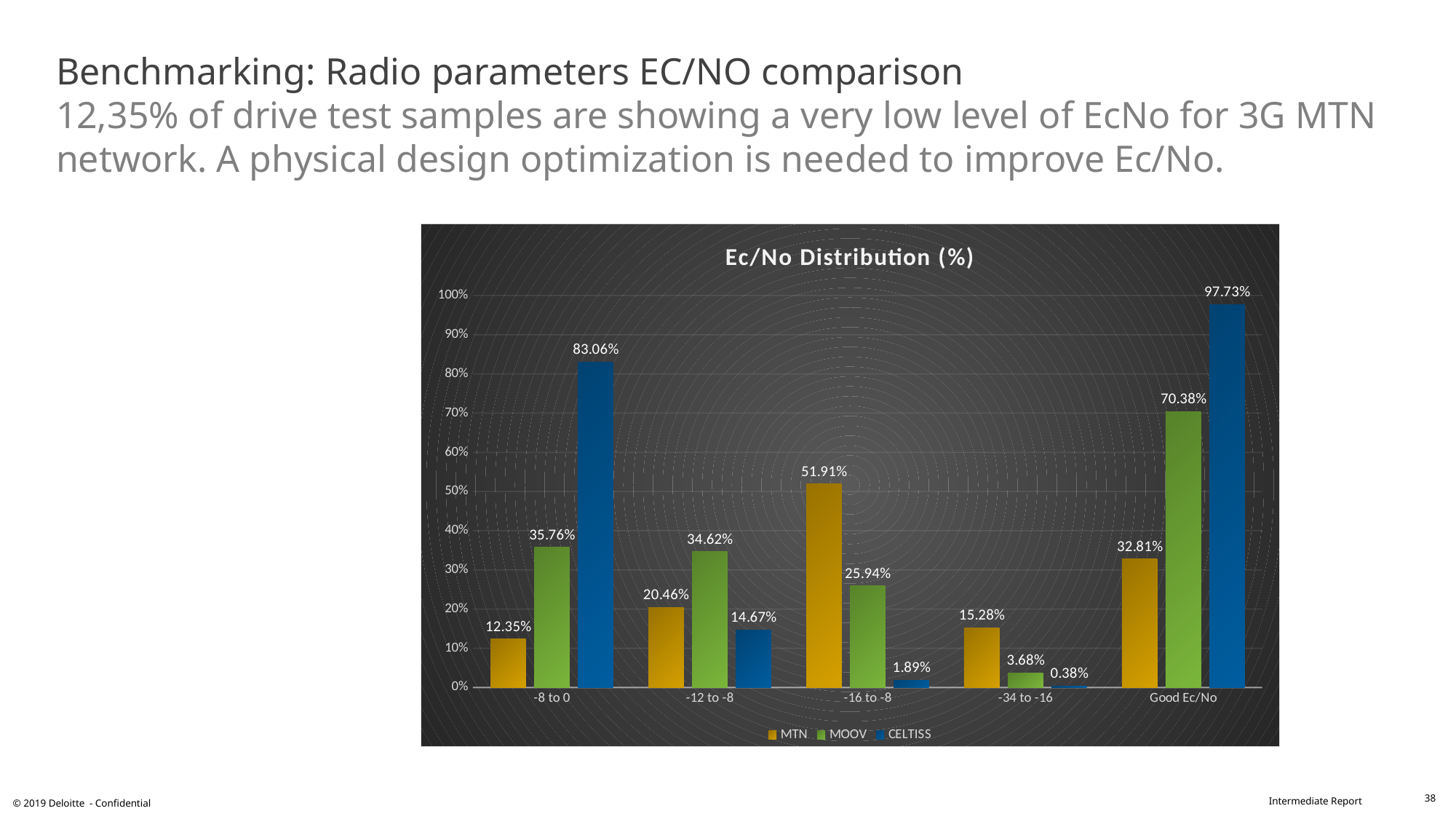
Which category has the lowest CELTISS value? -34 to -16 Which is larger in the -16 to -8 category, the MTN value or the MOOV value? MTN What kind of chart is shown on the slide? Bar chart How many categories are shown on the x axis? 5 What is the MTN value for the -8 to 0 category? 12.35% What is the title of the chart? Ec/No Distribution (%) What is the CELTISS value for the Good Ec/No category? 97.73% Which category has the highest MTN value? -16 to -8 Which series is shown in blue? CELTISS How many series does the legend list? 3 What is the MOOV value for the -12 to -8 category? 34.62% What is the difference between the CELTISS and MTN values in the -8 to 0 category? 70.71%